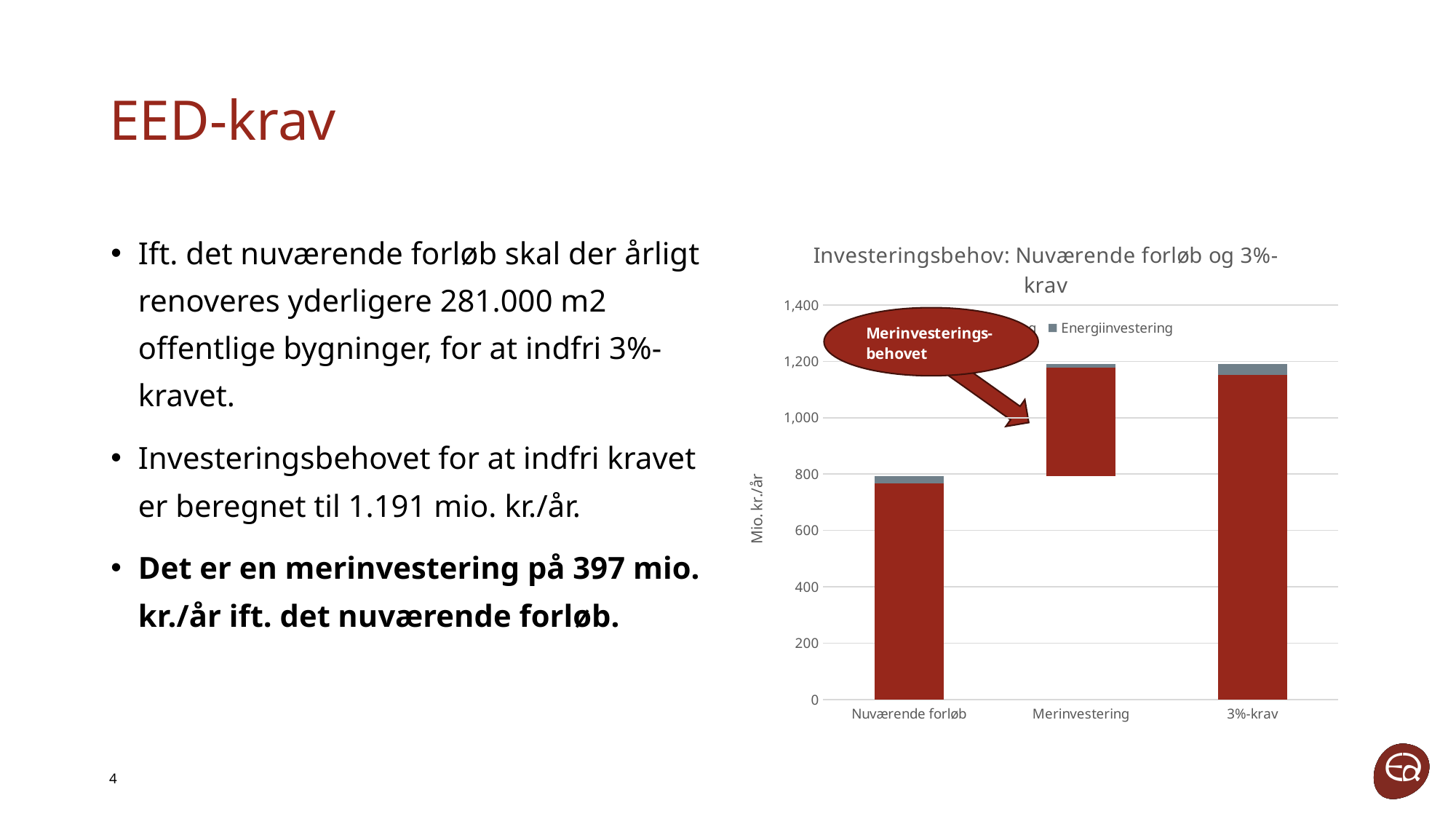
What is the title of the chart? Investeringsbehov: Nuværende forløb og 3%-krav Is the total value for Nuværende forløb greater or less than 1,000? less How many categories are shown on the x axis of the chart? 3 Which category has the lowest bar top in the chart? Nuværende forløb What kind of chart is shown on the slide? bar chart Is the total value for 3%-krav greater or less than 1,000? greater Which bar reaches higher, Nuværende forløb or 3%-krav? 3%-krav What is the label of the first category on the x axis? Nuværende forløb Is the total value for Nuværende forløb greater or less than 600? greater What is the label on the vertical axis of the chart? Mio. kr./år